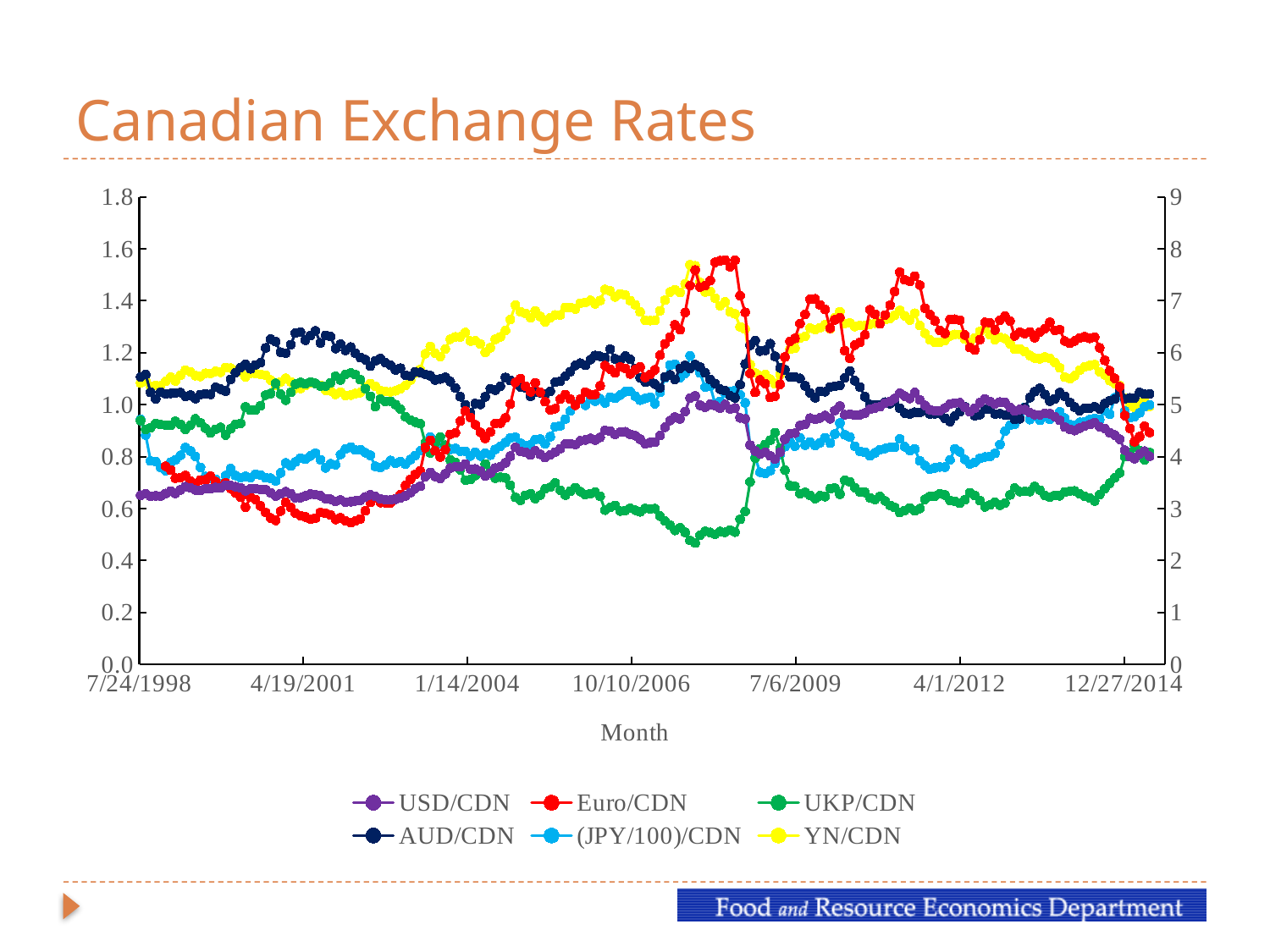
Is the lowest value of UKP/CDN around 2008 greater or less than 0.6 on the left axis? less Is the value for USD/CDN at 7/24/1998 greater or less than 0.8 on the left axis? less At 7/24/1998, which is higher, AUD/CDN or USD/CDN? AUD/CDN Is the peak value of Euro/CDN around 2008 greater or less than 1.4 on the left axis? greater What is the highest value shown on the right y axis? 9 What is the label of the x axis? Month What kind of chart is shown on the slide? line chart How many series does the legend list? 6 What is the highest value shown on the left y axis? 1.8 How many date labels are shown along the x axis? 7 Does USD/CDN generally rise or fall between 7/24/1998 and 10/10/2006? rise